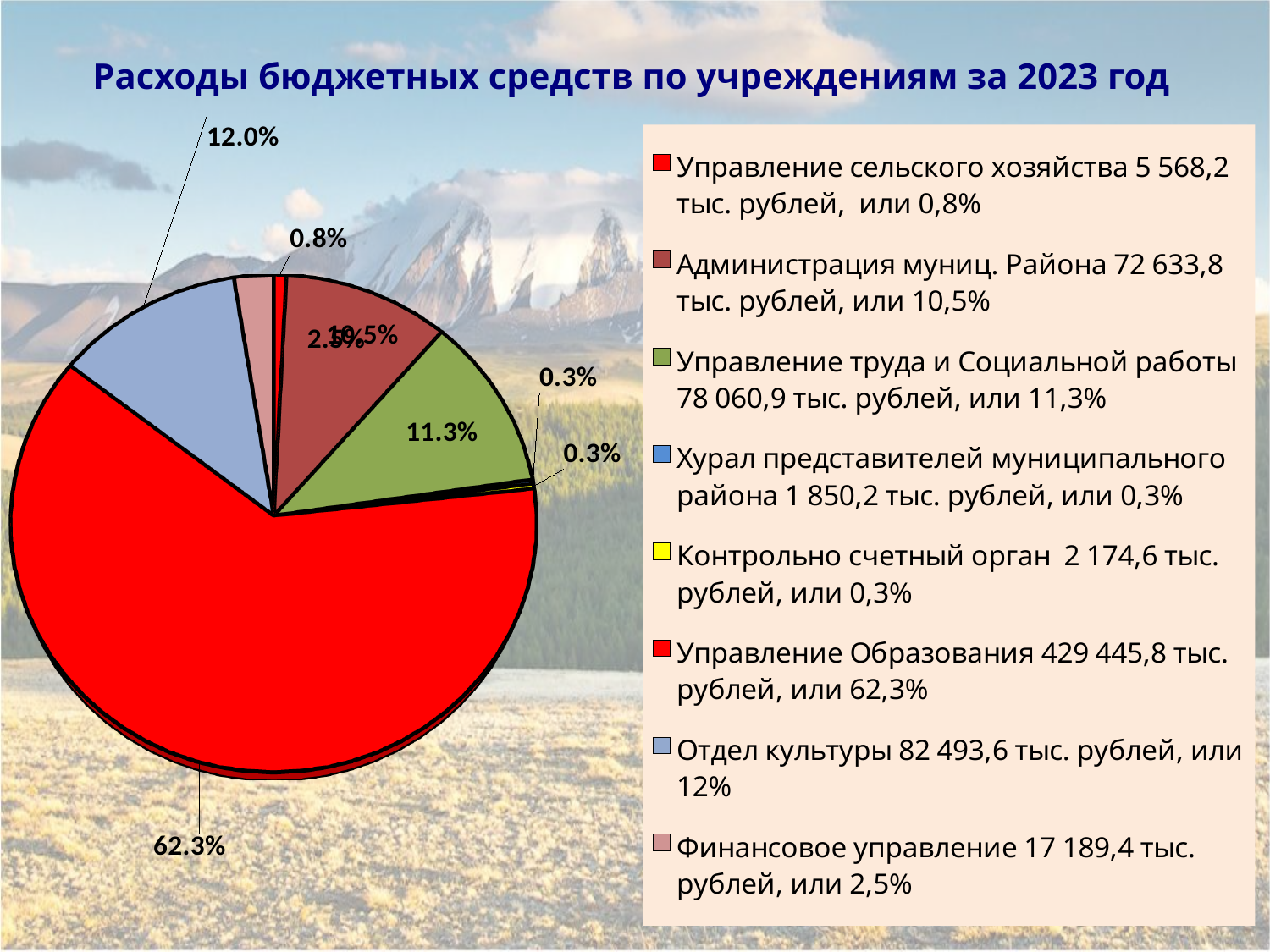
What amount in тыс. рублей is shown for Управление труда и Социальной работы? 78 060,9 What is the difference in percentage points between the share of Управление Образования and the share of Отдел культуры? 50.3 What share of the pie does Управление Образования take? 62.3% Which is larger: the share for Отдел культуры or the share for Управление труда и Социальной работы? Отдел культуры What colour is the slice for Управление труда и Социальной работы? Green How many categories does the legend of the pie chart list? 8 What kind of chart is shown on the slide? Pie chart What amount in тыс. рублей is shown for Администрация муниц. Района? 72 633,8 What share of the pie does Отдел культуры take? 12.0% Which category has the largest slice of the pie? Управление Образования What is the title of the chart? Расходы бюджетных средств по учреждениям за 2023 год What percentage is shown for Финансовое управление? 2,5%